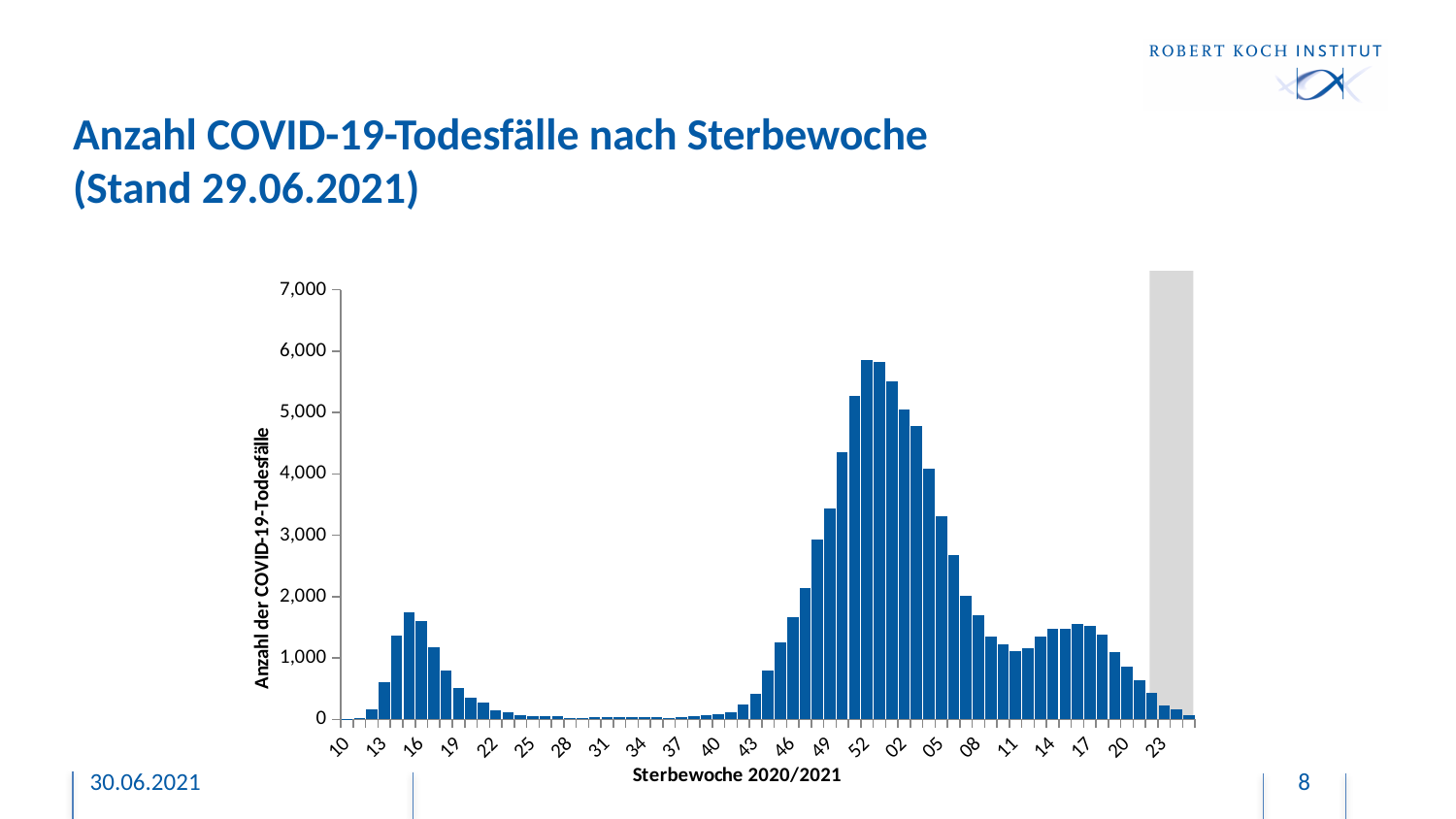
What is the label of the x axis? Sterbewoche 2020/2021 Is the value for week 23 greater or less than 1,000? less Is the value for week 52 greater or less than 5,000? greater Is the value for week 13 greater or less than 1,000? less What is the title of the chart on the slide? Anzahl COVID-19-Todesfälle nach Sterbewoche (Stand 29.06.2021) What kind of chart is shown on the slide? bar chart Do the values rise or fall from week 43 to week 52? rise Do the values rise or fall from week 02 to week 11? fall